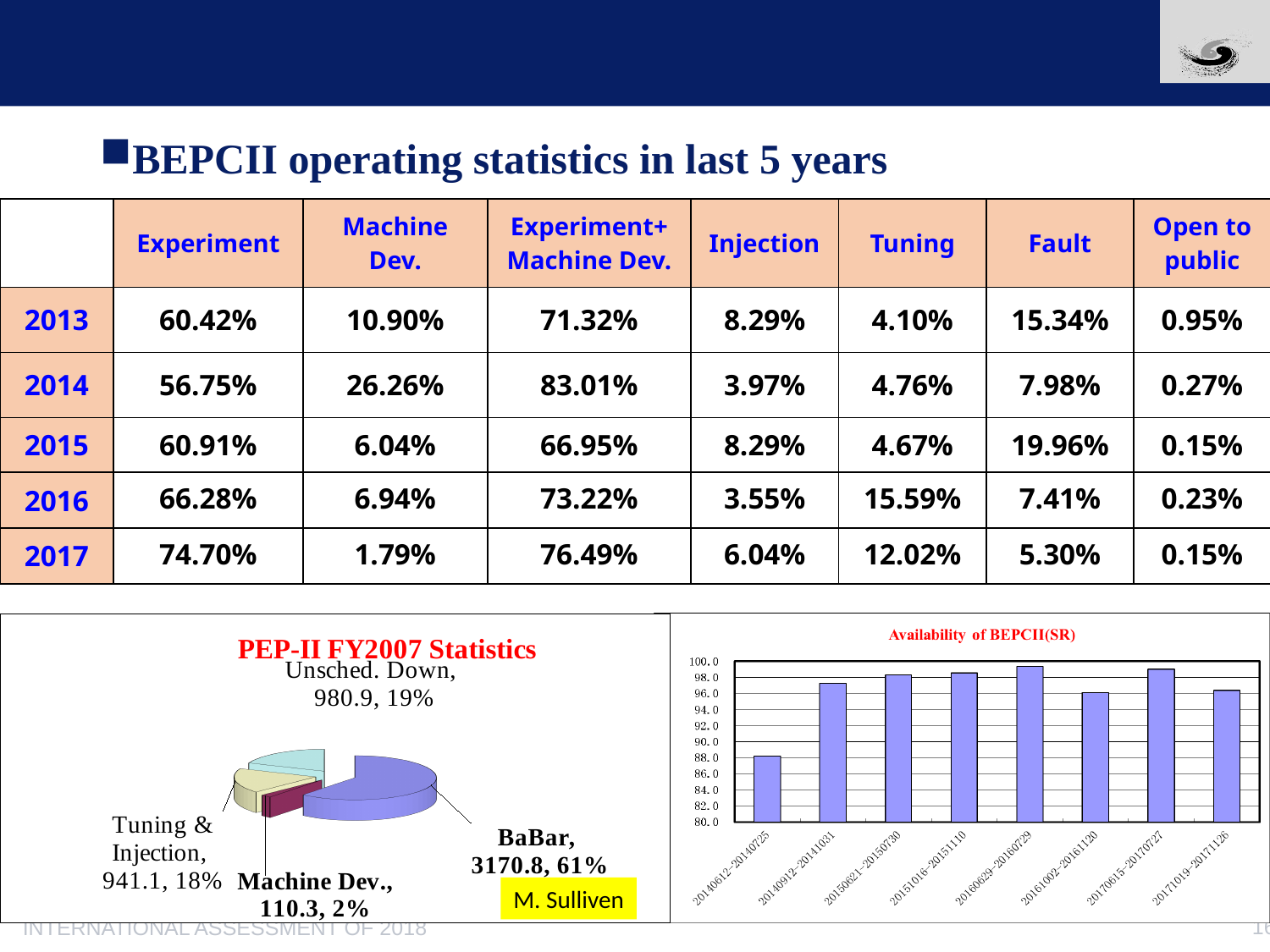
In the Availability of BEPCII(SR) chart, which period has the lowest bar? 20140612-20140725 In the Availability of BEPCII(SR) chart, is the value for 20140612-20140725 greater or less than 90.0? less In the PEP-II FY2007 Statistics pie chart, which slice is the largest? BaBar What kind of chart is the Availability of BEPCII(SR) chart? bar chart In the PEP-II FY2007 Statistics pie chart, which slice is the smallest? Machine Dev. In the PEP-II FY2007 Statistics pie chart, what value and share are shown for BaBar? 3170.8, 61% How many slices does the PEP-II FY2007 Statistics pie chart have? 4 In the PEP-II FY2007 Statistics pie chart, what value is shown for Unsched. Down? 980.9 In the PEP-II FY2007 Statistics pie chart, what is the difference between the Unsched. Down value and the Tuning & Injection value? 39.8 In the Availability of BEPCII(SR) chart, which is larger, the value for 20140612-20140725 or the value for 20140912-20141031? 20140912-20141031 How many bars are in the Availability of BEPCII(SR) chart? 8 In the PEP-II FY2007 Statistics pie chart, what share of the pie does Tuning & Injection have? 18%